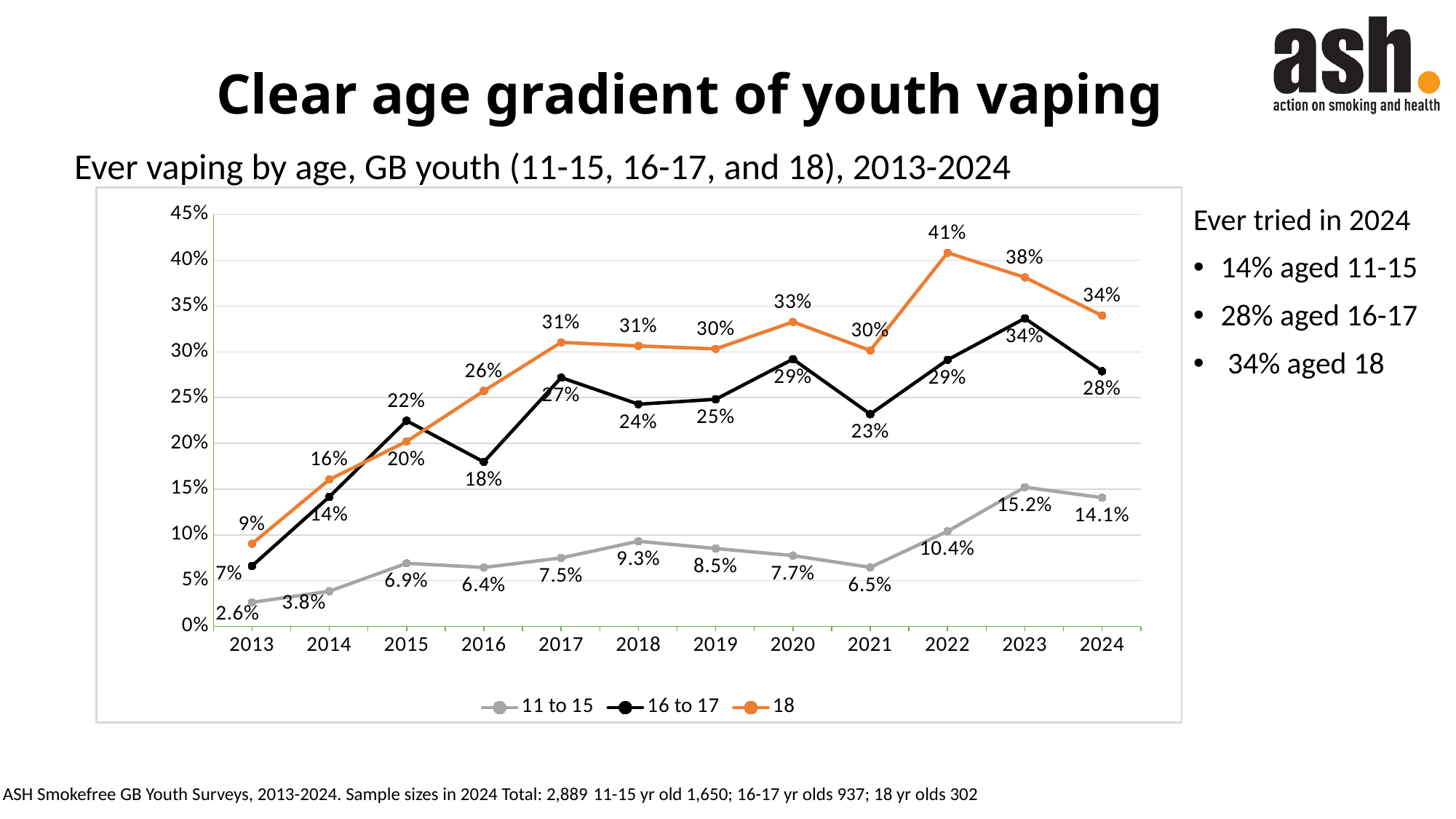
Does the 11 to 15 series rise or fall from 2013 to 2018? Rise How many years are shown on the x axis? 12 In which year is the 11 to 15 series at its lowest value? 2013 Which colour is used for the 18 series? Orange How many series does the legend list? 3 What kind of chart is shown on the slide? Line chart What is the value for the 18 series in 2022? 41% What is the value for the 16 to 17 series in 2016? 18% Which series has the larger value in 2015: 16 to 17 or 18? 16 to 17 What is the value for the 11 to 15 series in 2023? 15.2% What is the difference between the 18 series and the 16 to 17 series in 2024? 6% In which year does the 18 series reach its highest value? 2022